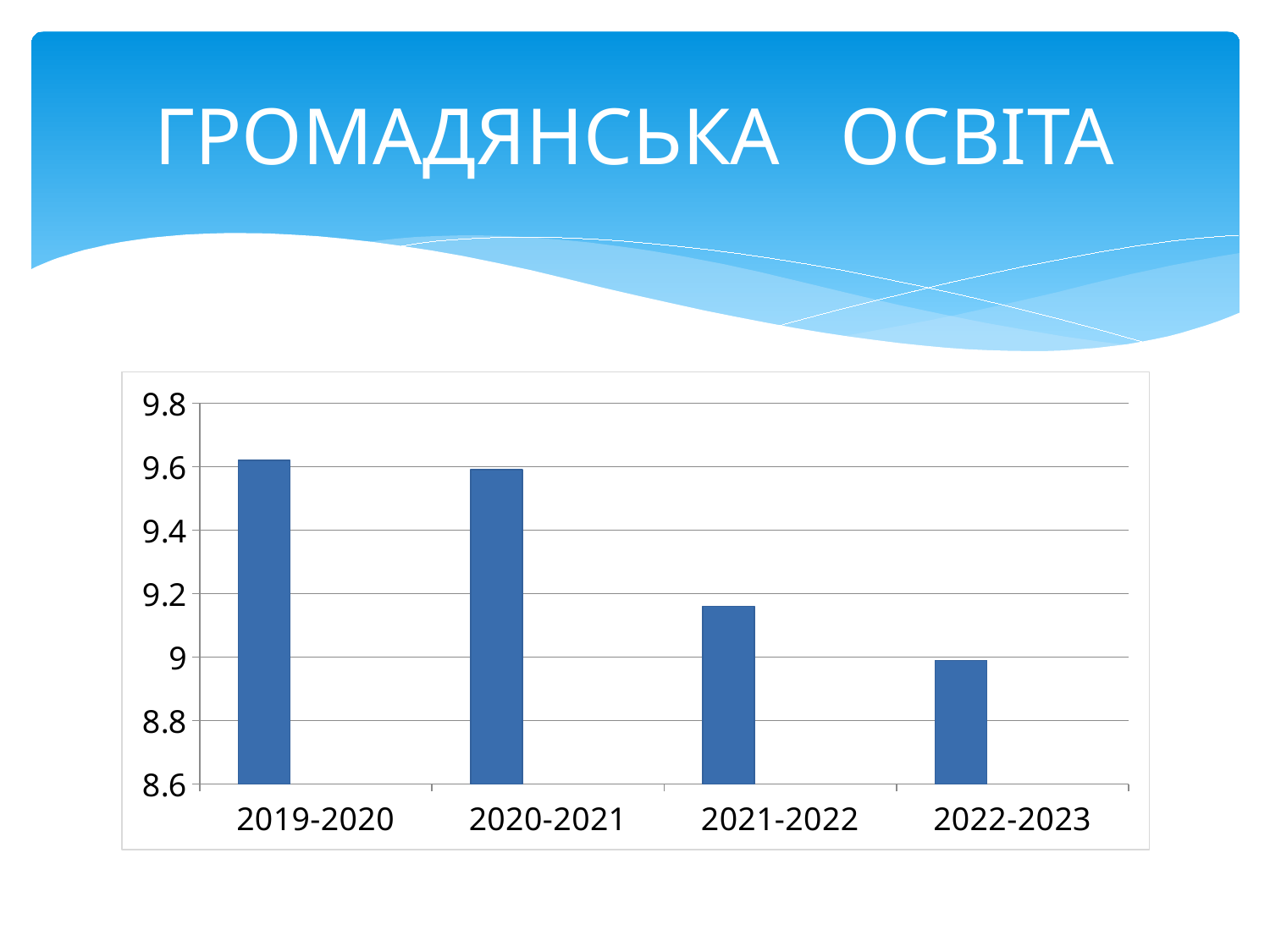
Is the value for 2019-2020 greater or less than 9.4? greater Is the value for 2022-2023 greater or less than 9.2? less Is the value for 2020-2021 greater or less than 9.4? greater Which is larger, the value for 2020-2021 or the value for 2022-2023? 2020-2021 Do the values rise or fall from 2019-2020 to 2022-2023? fall What is the title shown at the top of the slide above the chart? ГРОМАДЯНСЬКА ОСВІТА How many categories (school years) are shown on the x axis of the chart? 4 Which is larger, the value for 2019-2020 or the value for 2021-2022? 2019-2020 What kind of chart is shown on the slide? bar chart Which school year has the lowest value in the chart? 2022-2023